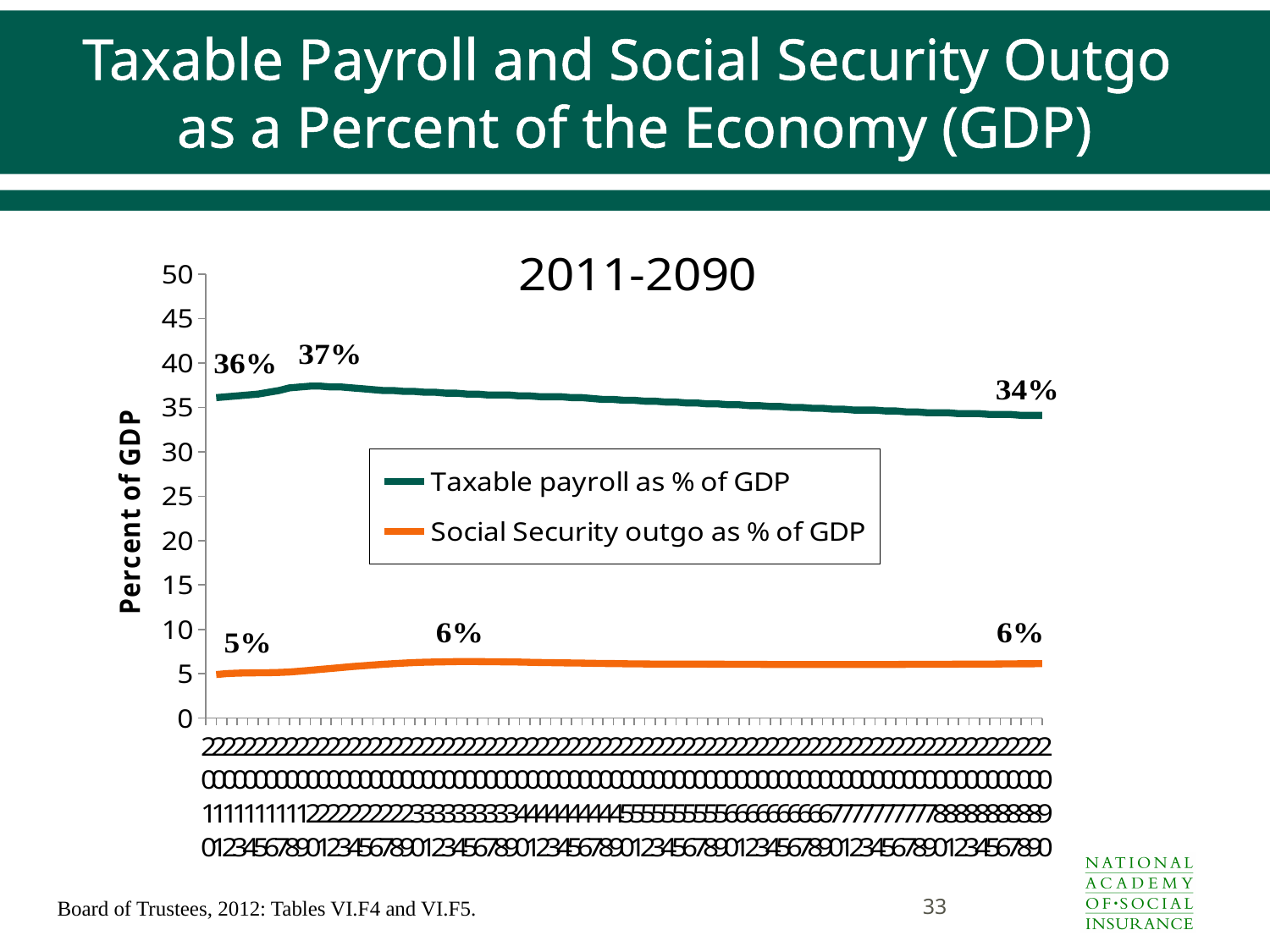
By how many percentage points does the labelled taxable payroll value fall from 2011 (36%) to 2090 (34%)? 2 percentage points Is the value of Social Security outgo as % of GDP in the middle of the period greater or less than 10? less Which series has the higher values throughout the chart, taxable payroll or Social Security outgo? Taxable payroll as % of GDP What is the labelled value of Social Security outgo as % of GDP at the start of the period (2011)? 5% Overall, does taxable payroll as % of GDP rise or fall from 2011 to 2090? fall What is the label on the vertical axis of the chart? Percent of GDP What is the labelled value of taxable payroll as % of GDP at the end of the period (2090)? 34% What is the labelled value of Social Security outgo as % of GDP at the end of the period (2090)? 6% How many series does the legend list? 2 What is the labelled value of taxable payroll as % of GDP at the start of the period (2011)? 36% What kind of chart is shown on the slide? line chart What is the labelled peak value of taxable payroll as % of GDP? 37%